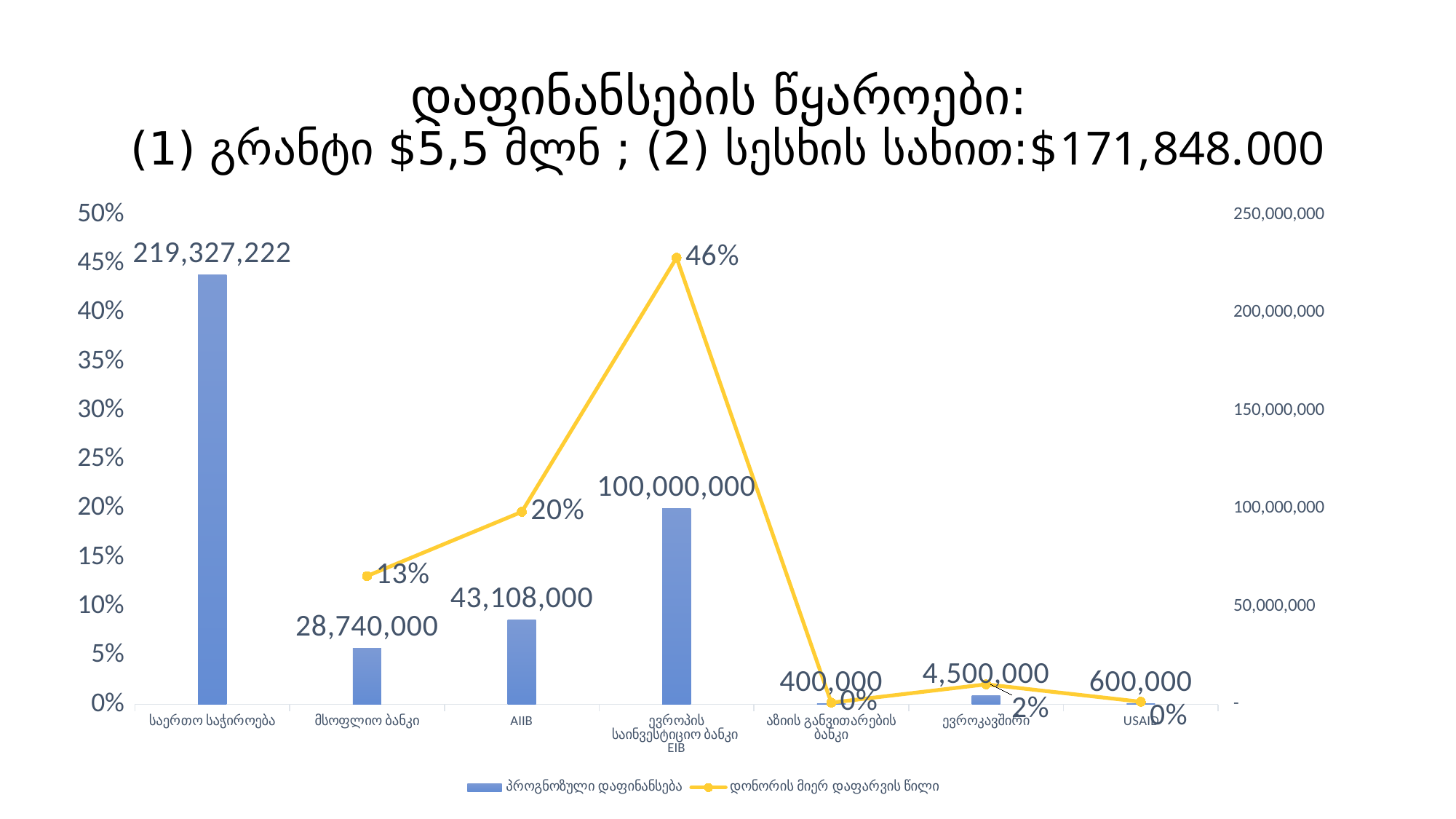
How many series does the legend list? 2 What is the donor coverage share (დონორის მიერ დაფარვის წილი) for ევროპის საინვესტიციო ბანკი EIB? 46% What is the projected financing value for მსოფლიო ბანკი? 28,740,000 How many categories are shown on the x axis? 7 What is the projected financing (პროგნოზული დაფინანსება) value for AIIB? 43,108,000 Which has a larger donor coverage share, AIIB or მსოფლიო ბანკი? AIIB What is the difference between the projected financing for ევროპის საინვესტიციო ბანკი EIB and AIIB? 56,892,000 What is the label of the line series in the legend? დონორის მიერ დაფარვის წილი Which category has the highest projected financing bar? საერთო საჭიროება What kind of chart is this? Combined bar and line chart Which category has the lowest projected financing bar? აზიის განვითარების ბანკი What is the donor coverage share for ევროკავშირი? 2%